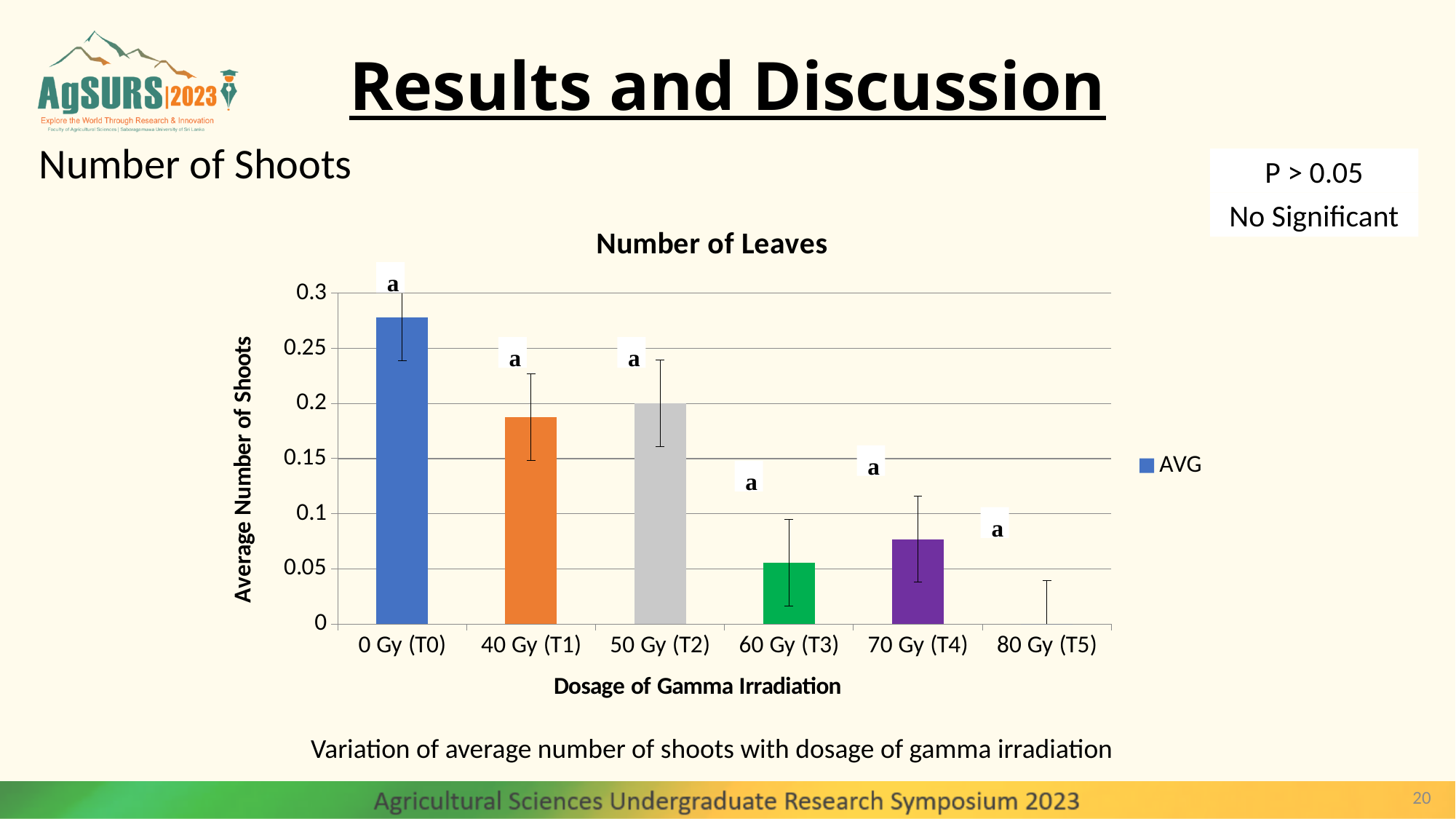
Which dosage has the lowest average number of shoots? 80 Gy (T5) How many dosage categories are shown on the x axis of the chart? 6 Which has a larger average number of shoots, 60 Gy (T3) or 70 Gy (T4)? 70 Gy (T4) Is the value for 60 Gy (T3) greater or less than 0.1? less Which has a larger average number of shoots, 0 Gy (T0) or 40 Gy (T1)? 0 Gy (T0) How many series does the chart legend list? 1 What is the title of the chart? Number of Leaves Is the value for 0 Gy (T0) greater or less than 0.25? greater Is the value for 70 Gy (T4) greater or less than 0.1? less What kind of chart is shown on the slide? bar chart Which dosage has the highest average number of shoots? 0 Gy (T0)